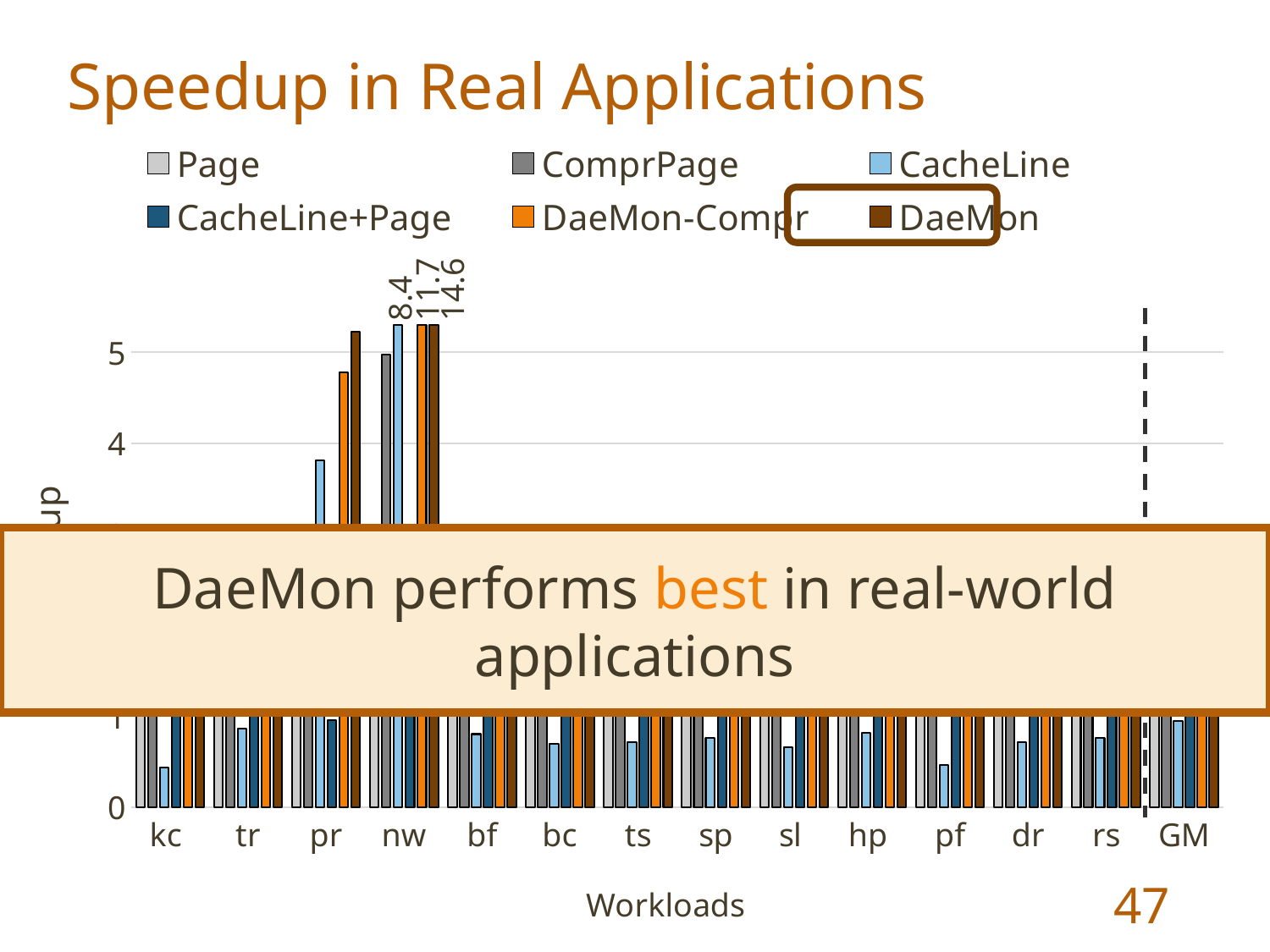
Is the CacheLine value for the kc workload greater or less than 1? less For the nw workload, which is larger: the CacheLine speedup or the DaeMon speedup? DaeMon How many workload categories are shown on the x axis? 14 What is the title of the x axis? Workloads What kind of chart is shown on the slide? bar chart Is the DaeMon-Compr value for the pr workload greater or less than 4? greater What is the speedup of DaeMon for the nw workload? 14.6 Which series has the highest speedup for the nw workload? DaeMon What is the speedup of DaeMon-Compr for the nw workload? 11.7 What is the difference between the DaeMon and DaeMon-Compr speedups for the nw workload? 2.9 How many series does the legend list? 6 What is the speedup of CacheLine for the nw workload? 8.4